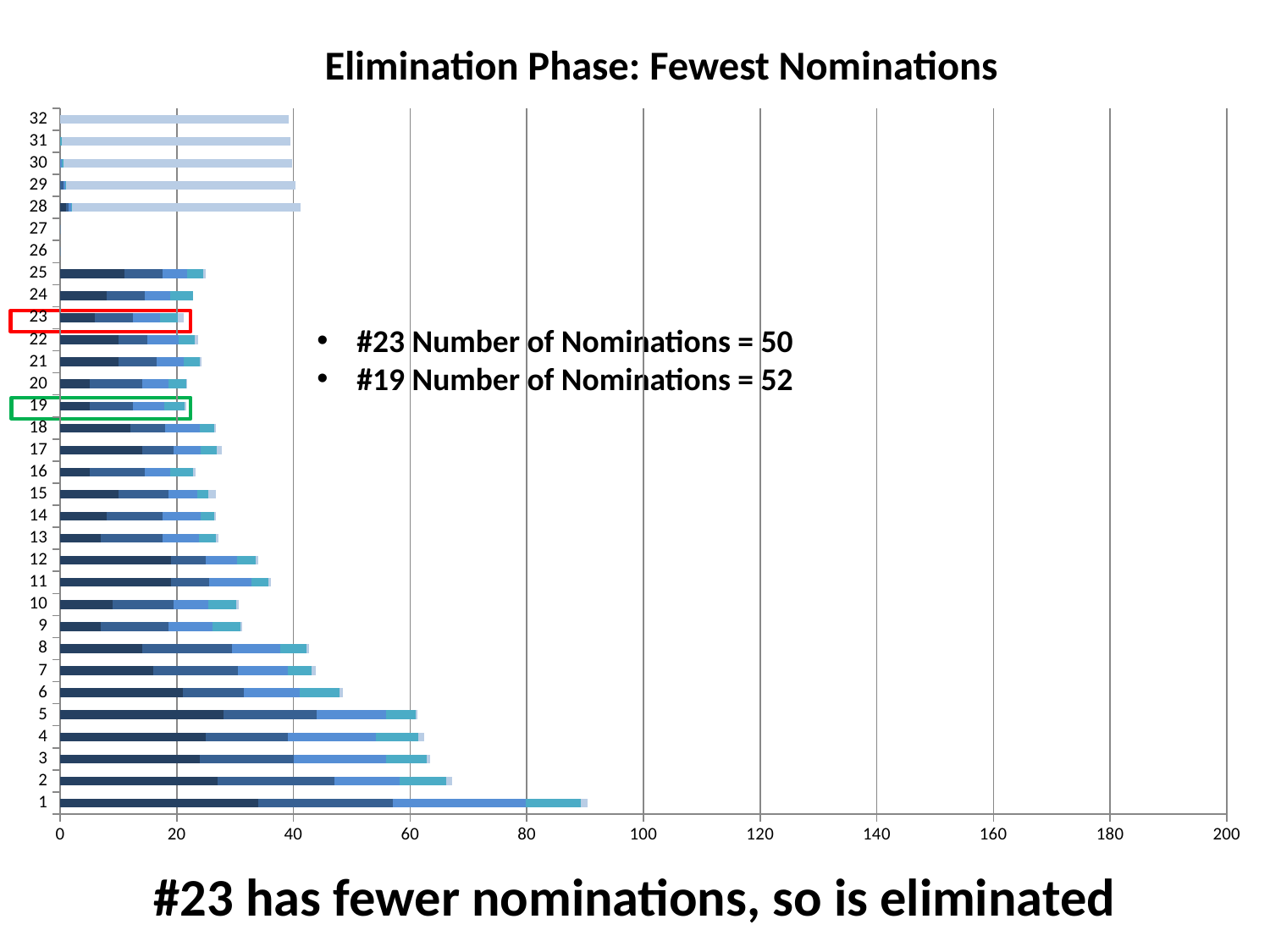
How many categories are listed on the vertical axis of the chart? 32 What kind of chart is shown on the slide? bar chart Is the value for category 6 greater or less than 40? greater Is the value for category 2 greater or less than 60? greater Which has the longer bar, category 8 or category 12? 8 Which category label is outlined with a red box on the chart? 23 Is the value for category 1 greater or less than 80? greater Which category has the longest bar in the chart? 1 What is the title of the chart? Elimination Phase: Fewest Nominations What is the highest value shown on the horizontal axis? 200 Which has the longer bar, category 1 or category 2? 1